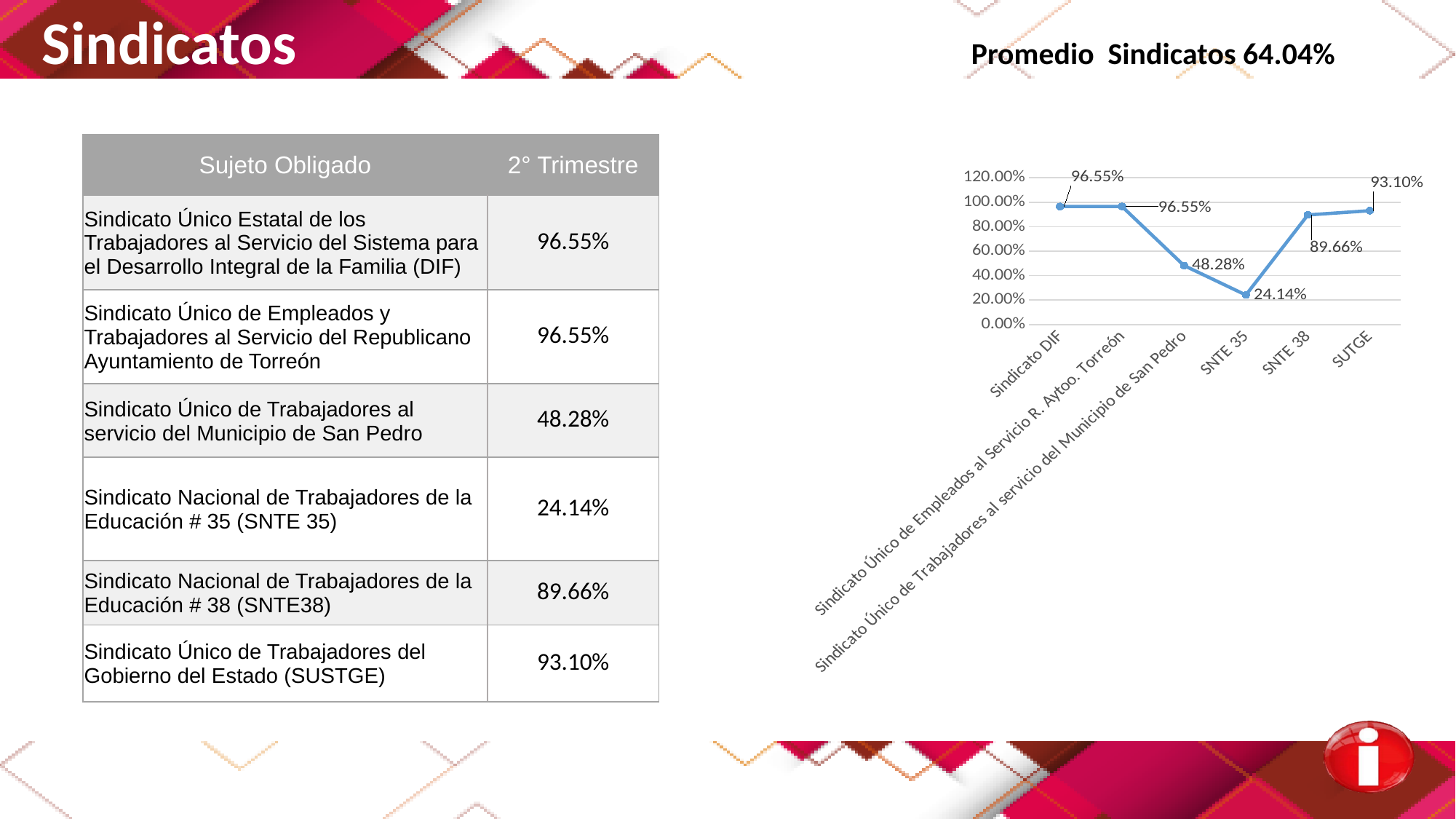
What type of chart is shown on the slide? line chart How many categories are plotted on the x axis of the chart? 6 What is the value for SUTGE in the chart? 93.10% Which is larger, the value for SNTE 38 or the value for Sindicato Único de Trabajadores al servicio del Municipio de San Pedro? SNTE 38 What is the highest value shown on the chart's y axis? 120.00% What is the value for SNTE 35 in the chart? 24.14% What is the value for SNTE 38 in the chart? 89.66% What is the difference between the values for SUTGE and SNTE 38? 3.44% Is the value for SNTE 35 greater or less than 40.00%? less What is the value for Sindicato DIF in the chart? 96.55% What is the difference between the values for Sindicato DIF and SNTE 35? 72.41% Which category has the lowest value in the chart? SNTE 35